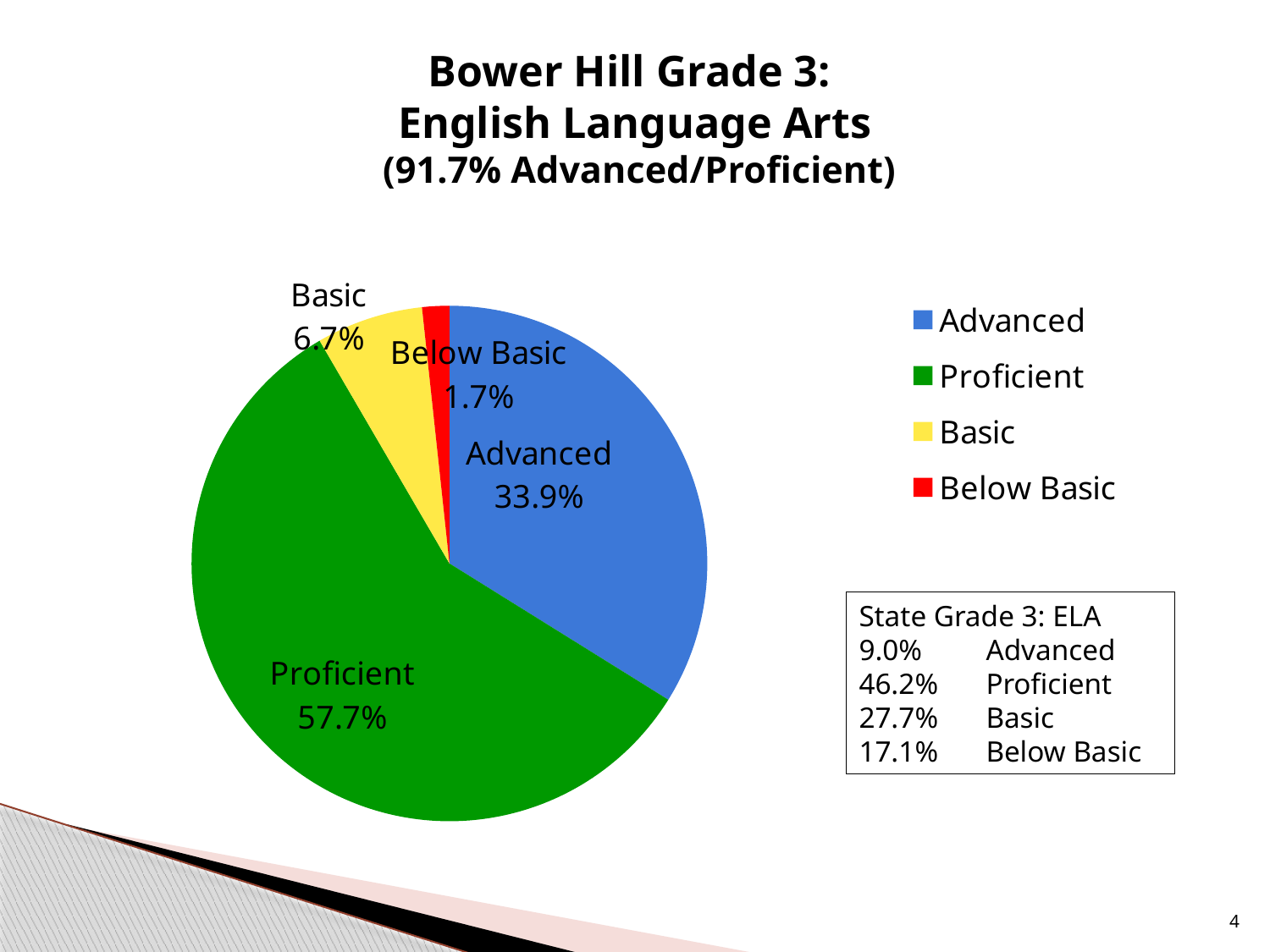
How many slices does the pie chart have? 4 Which is larger, the Basic slice or the Below Basic slice? Basic Which performance level has the largest share of the pie? Proficient What percentage of students scored Below Basic? 1.7% What is the difference in percentage points between Proficient and Advanced? 23.8 What percentage of Bower Hill Grade 3 students scored Proficient in English Language Arts? 57.7% How many entries does the legend list? 4 Which performance level has the smallest share of the pie? Below Basic What percentage of students scored Advanced? 33.9% What type of chart is shown on the slide? Pie chart What percentage of students scored Basic? 6.7% What colour represents the Proficient slice? Green